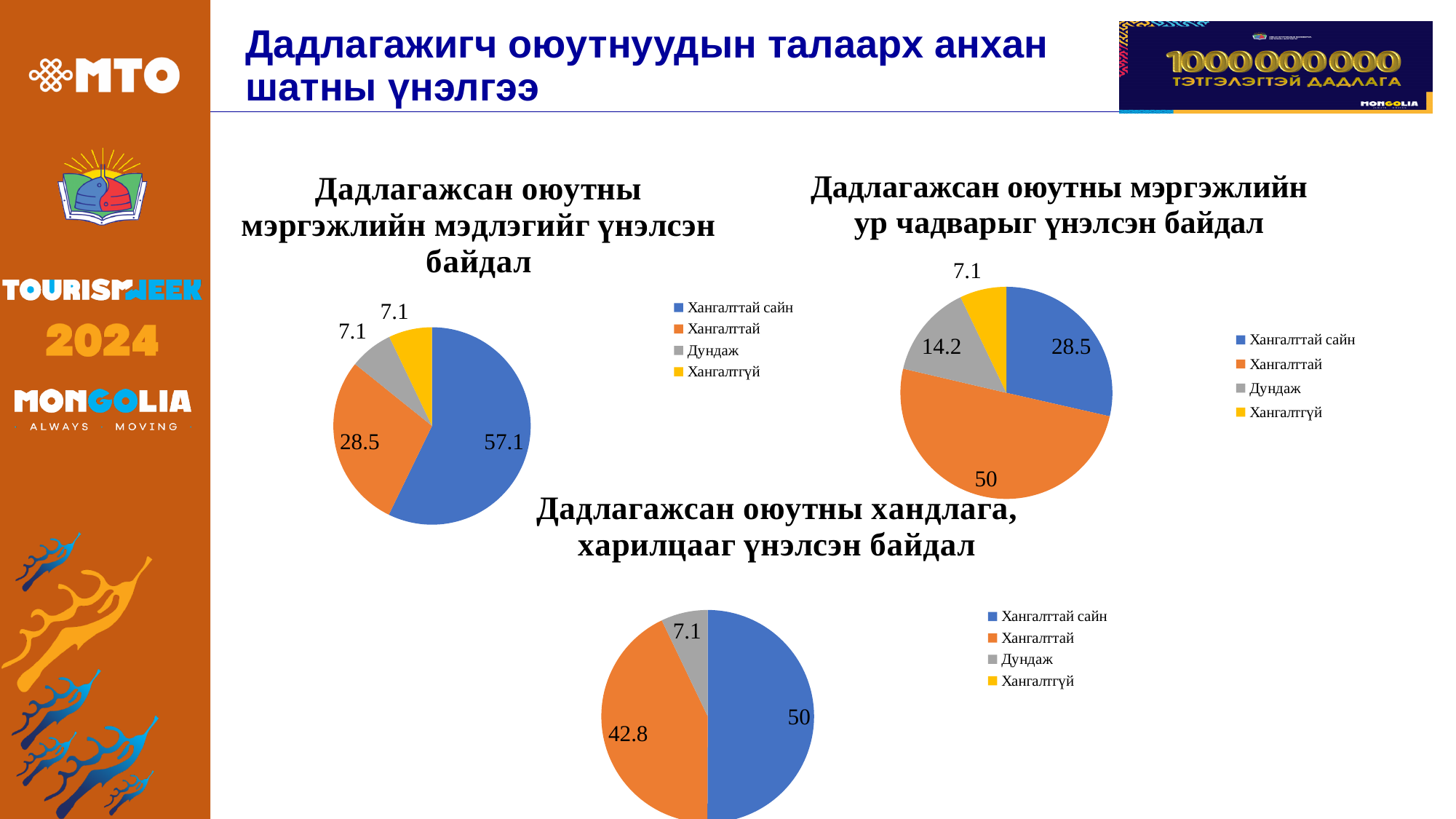
In the top-right pie chart (Дадлагажсан оюутны мэргэжлийн ур чадварыг үнэлсэн байдал), which is larger: Хангалттай сайн or Хангалттай? Хангалттай What type of chart is used for Дадлагажсан оюутны мэргэжлийн ур чадварыг үнэлсэн байдал? Pie chart In the top-left pie chart (Дадлагажсан оюутны мэргэжлийн мэдлэгийг үнэлсэн байдал), which category has the largest slice? Хангалттай сайн In the top-right pie chart (Дадлагажсан оюутны мэргэжлийн ур чадварыг үнэлсэн байдал), which category has the smallest slice? Хангалтгүй In the bottom pie chart (Дадлагажсан оюутны хандлага, харилцааг үнэлсэн байдал), what is the value for Хангалттай? 42.8 In the top-left pie chart (Дадлагажсан оюутны мэргэжлийн мэдлэгийг үнэлсэн байдал), what is the value for Хангалттай сайн? 57.1 In the top-left pie chart (Дадлагажсан оюутны мэргэжлийн мэдлэгийг үнэлсэн байдал), what is the difference between Хангалттай сайн and Хангалттай? 28.6 In the top-right pie chart (Дадлагажсан оюутны мэргэжлийн ур чадварыг үнэлсэн байдал), what is the value for Хангалттай? 50 In the bottom pie chart (Дадлагажсан оюутны хандлага, харилцааг үнэлсэн байдал), what is the difference between Хангалттай сайн and Дундаж? 42.9 How many entries does the legend of the bottom pie chart (Дадлагажсан оюутны хандлага, харилцааг үнэлсэн байдал) list? 4 In the top-left pie chart (Дадлагажсан оюутны мэргэжлийн мэдлэгийг үнэлсэн байдал), what is the value for Хангалттай? 28.5 In the top-right pie chart (Дадлагажсан оюутны мэргэжлийн ур чадварыг үнэлсэн байдал), what is the value for Дундаж? 14.2